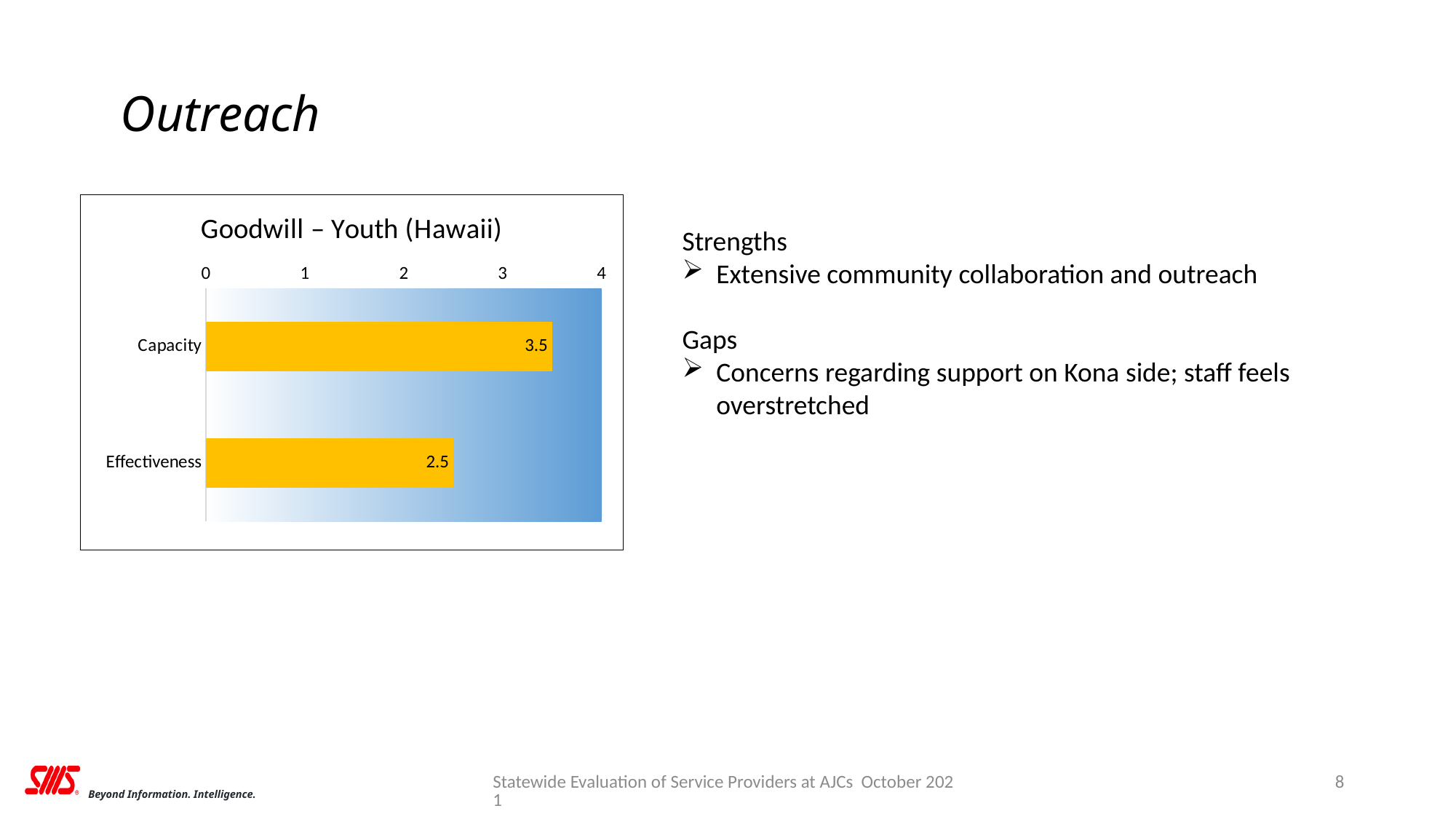
Which category has the lowest value? Effectiveness What is the value for Capacity? 3.5 What is the title of the chart? Goodwill – Youth (Hawaii) What is the maximum value shown on the chart's axis? 4 How many categories are shown in the chart? 2 What is the value for Effectiveness? 2.5 What is the difference between the values for Capacity and Effectiveness? 1 Is the value for Capacity greater or less than 3? greater Is the value for Effectiveness greater or less than 3? less Which is larger, the value for Capacity or the value for Effectiveness? Capacity What kind of chart is shown on the slide? bar chart Which category has the highest value? Capacity